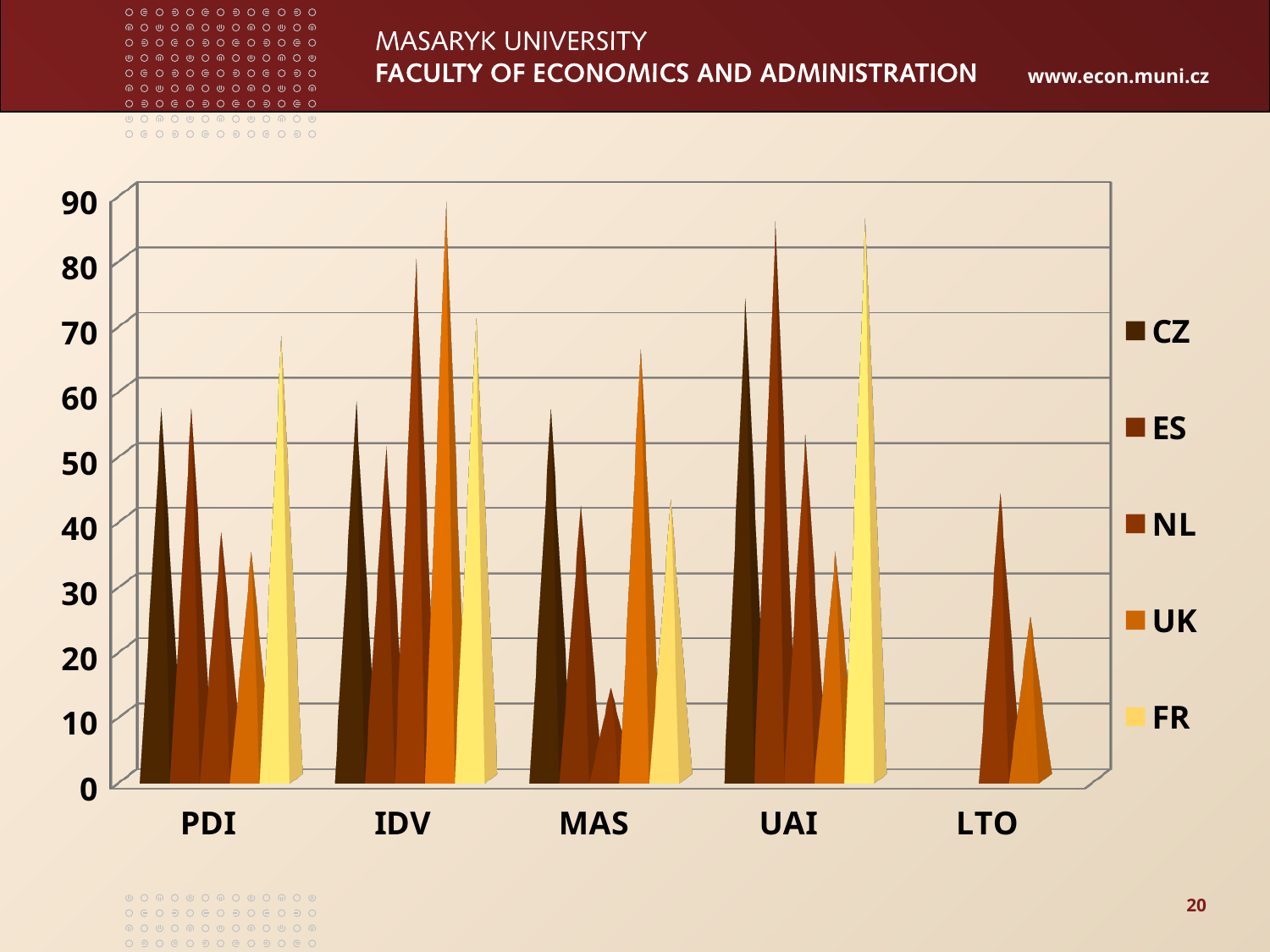
How many series does the legend list? 5 Is the value for UK in the UAI category greater or less than 40? less In the PDI category, which is larger, the value for CZ or the value for NL? CZ Which series has the highest value in the IDV category? UK Which series has the highest value in the PDI category? FR Is the value for FR in the PDI category greater or less than 60? greater Is the value for NL in the MAS category greater or less than 20? less Which series has the lowest value in the MAS category? NL How many categories are shown on the x axis? 5 What kind of chart is shown on the slide? bar chart Which category on the x axis has the fewest bars plotted? LTO